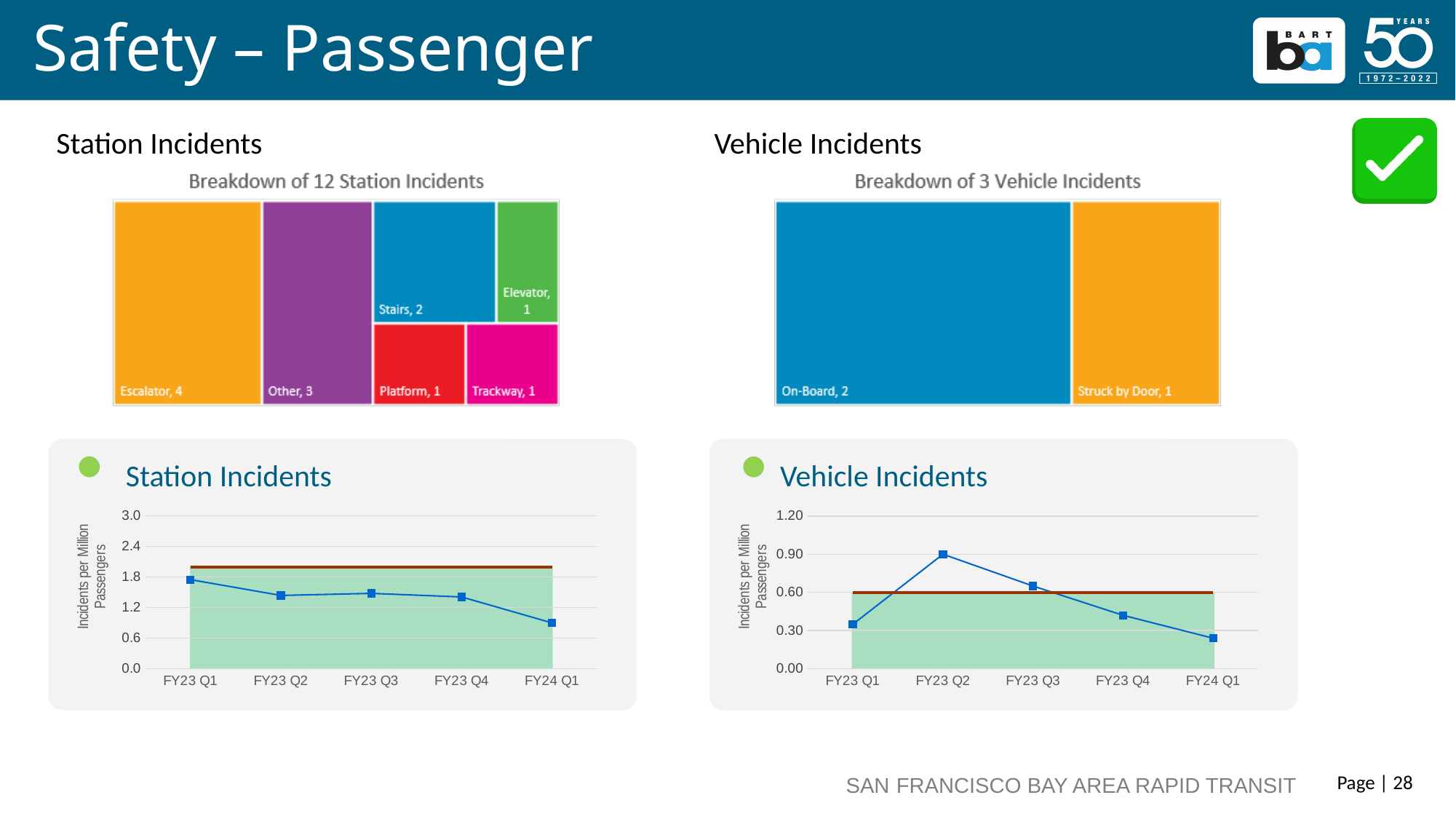
In the 'Breakdown of 12 Station Incidents' chart, what is the difference between the Escalator and Other incident counts? 1 In the 'Vehicle Incidents' line chart at the bottom right, which quarter has the highest incidents per million passengers? FY23 Q2 In the 'Station Incidents' line chart at the bottom left, which quarter has the lowest incidents per million passengers? FY24 Q1 In the 'Vehicle Incidents' line chart at the bottom right, is the value for FY23 Q1 greater or less than 0.60? less In the 'Breakdown of 12 Station Incidents' chart, how many incidents are attributed to Stairs? 2 In the 'Breakdown of 12 Station Incidents' chart, how many categories are shown? 6 In the 'Breakdown of 12 Station Incidents' chart, which category has the most incidents? Escalator In the 'Breakdown of 3 Vehicle Incidents' chart, how many incidents are attributed to On-Board? 2 In the 'Breakdown of 12 Station Incidents' chart, how many incidents are attributed to Escalator? 4 What kind of chart is the 'Vehicle Incidents' chart at the bottom right of the slide? Line chart In the 'Breakdown of 3 Vehicle Incidents' chart, which category has fewer incidents, On-Board or Struck by Door? Struck by Door In the 'Station Incidents' line chart at the bottom left, is the value for FY24 Q1 greater or less than 1.2? less